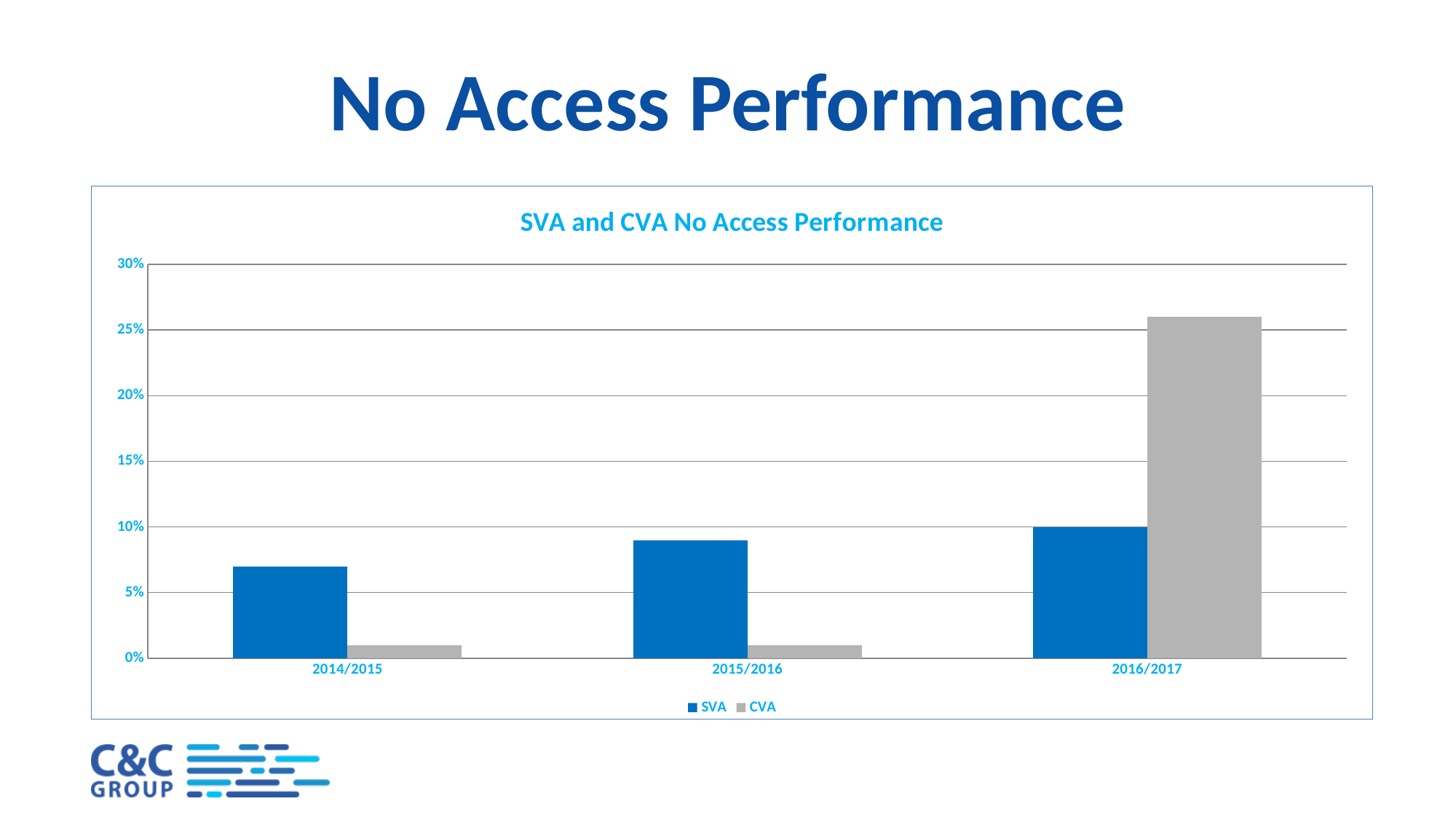
How many series does the legend list? 2 Do the SVA values rise or fall from 2014/2015 to 2016/2017? rise What is the SVA value for 2016/2017? 10% How many year categories are shown on the x axis? 3 Is the SVA value for 2014/2015 greater or less than 5%? greater In which year is the CVA value highest? 2016/2017 In 2016/2017, which is larger, SVA or CVA? CVA Is the CVA value for 2016/2017 greater or less than 25%? greater What is the title of the chart? SVA and CVA No Access Performance Is the CVA value for 2014/2015 greater or less than 5%? less What type of chart is shown on the slide? Bar chart In which year is the SVA value lowest? 2014/2015